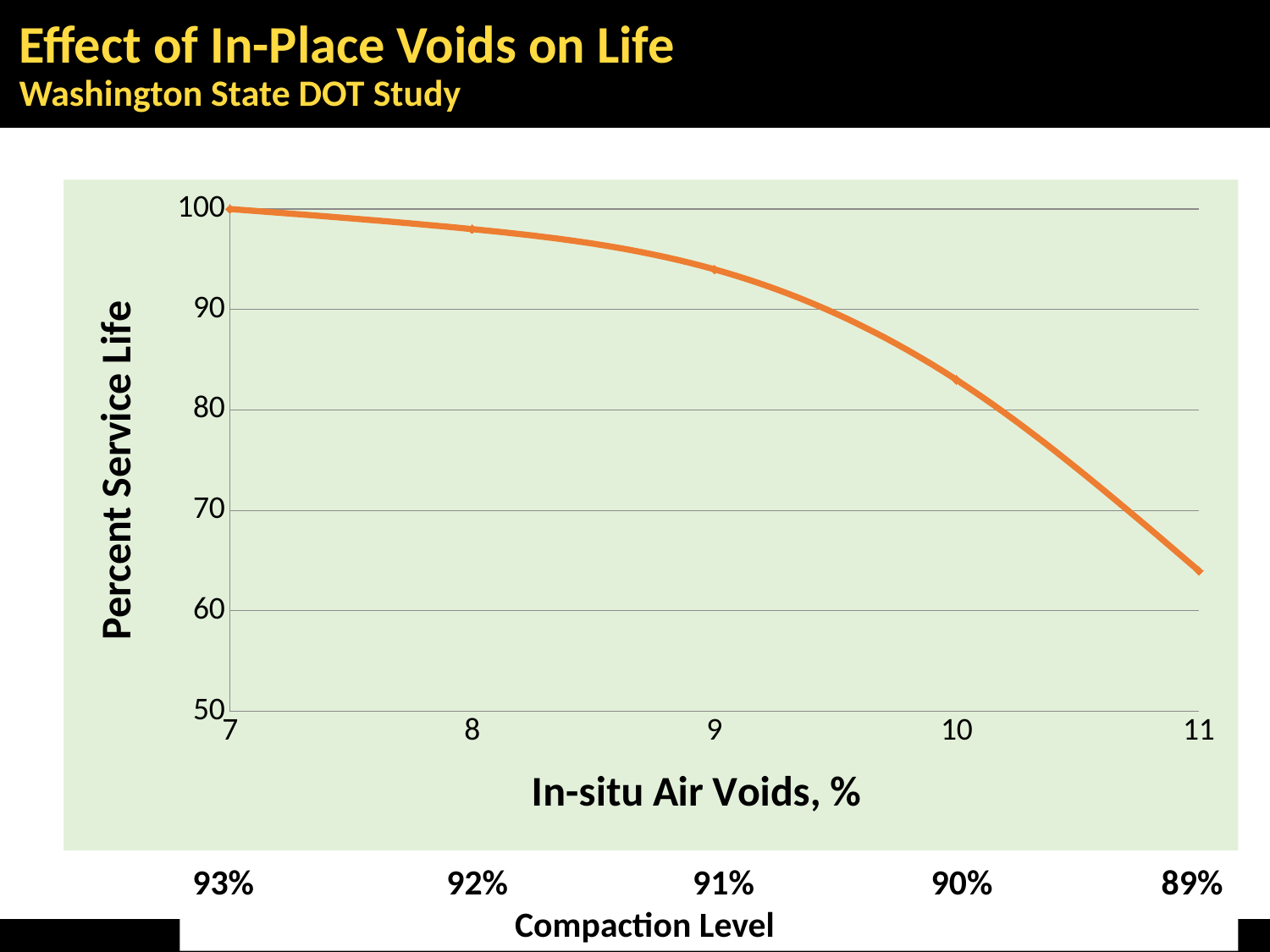
Is the Percent Service Life at 9% In-situ Air Voids greater or less than 90? greater Is the Percent Service Life at 11% In-situ Air Voids greater or less than 60? greater How many data points are plotted on the line? 5 At which In-situ Air Voids value is Percent Service Life highest? 7 At which In-situ Air Voids value is Percent Service Life lowest? 11 What Compaction Level corresponds to 11% In-situ Air Voids? 89% What kind of chart is shown on the slide? line chart What is the Percent Service Life at 7% In-situ Air Voids? 100 Which has a higher Percent Service Life: 8% or 10% In-situ Air Voids? 8% What is the title of the y axis? Percent Service Life Is the Percent Service Life at 10% In-situ Air Voids greater or less than 90? less Does Percent Service Life rise or fall as In-situ Air Voids increase from 7 to 11? fall